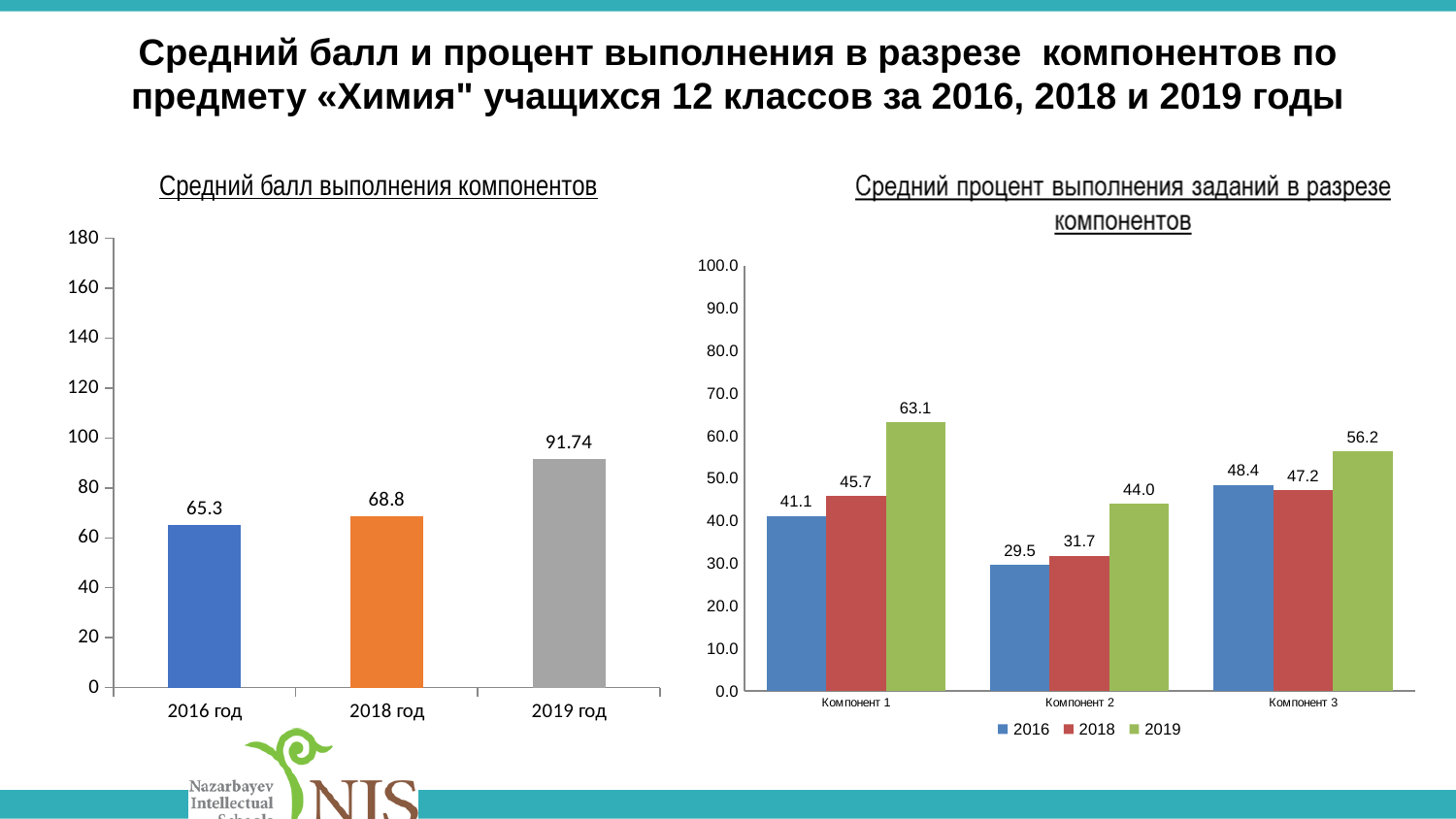
In the left chart 'Средний балл выполнения компонентов', how many bars are plotted? 3 In the right chart 'Средний процент выполнения заданий в разрезе компонентов', how many series does the legend list? 3 In the left chart 'Средний балл выполнения компонентов', do the values rise or fall from 2016 год to 2019 год? rise In the left chart 'Средний балл выполнения компонентов', what is the difference between the values for 2018 год and 2016 год? 3.5 In the right chart 'Средний процент выполнения заданий в разрезе компонентов', what is the difference between the 2019 and 2018 values for Компонент 2? 12.3 In the left chart 'Средний балл выполнения компонентов', which year has the lowest value? 2016 год In the right chart 'Средний процент выполнения заданий в разрезе компонентов', what is the value for 2016 in Компонент 2? 29.5 In the right chart 'Средний процент выполнения заданий в разрезе компонентов', which is larger for Компонент 3: the 2016 value or the 2018 value? 2016 What kind of chart is the left chart 'Средний балл выполнения компонентов'? bar chart In the right chart 'Средний процент выполнения заданий в разрезе компонентов', what is the value for 2019 in Компонент 1? 63.1 In the right chart 'Средний процент выполнения заданий в разрезе компонентов', which component has the lowest 2019 value? Компонент 2 In the left chart 'Средний балл выполнения компонентов', what is the value for 2019 год? 91.74